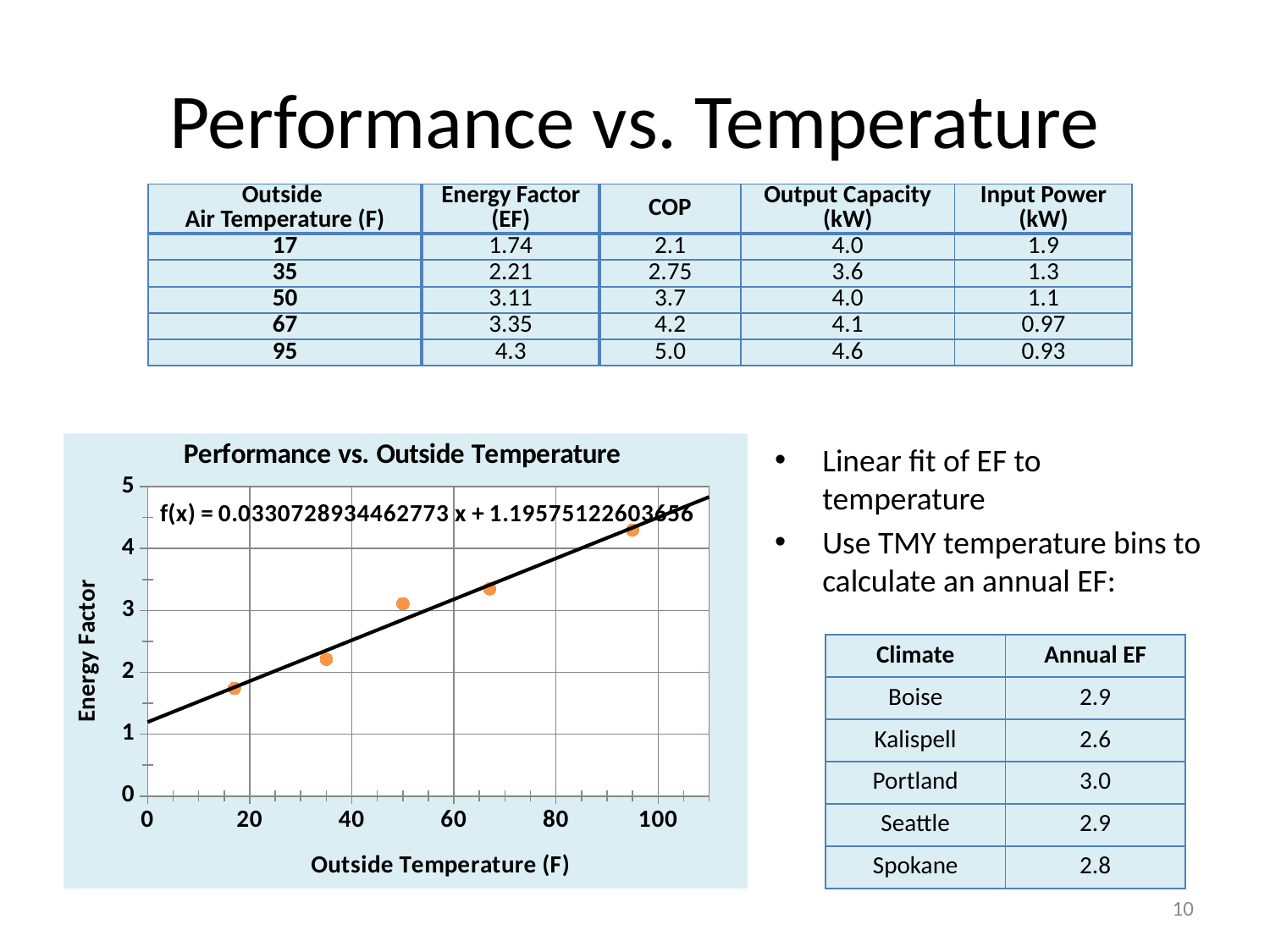
Is the Energy Factor of the data point near 35 F greater or less than 3? less What kind of chart is shown on the slide? Scatter chart with a linear trendline What is the title of the chart? Performance vs. Outside Temperature What is the trendline equation printed on the chart? f(x) = 0.0330728934462773 x + 1.19575122603656 Is the Energy Factor of the leftmost data point (near 17 F) greater or less than 2? less Which data point has the higher Energy Factor, the one near 17 F or the one near 95 F? The one near 95 F What is the label of the chart's vertical axis? Energy Factor Do the Energy Factor values rise or fall as Outside Temperature increases? Rise Is the Energy Factor of the data point near 67 F greater or less than 3? greater Which data point has the lower Energy Factor, the one near 35 F or the one near 67 F? The one near 35 F How many data points are plotted in the chart? 5